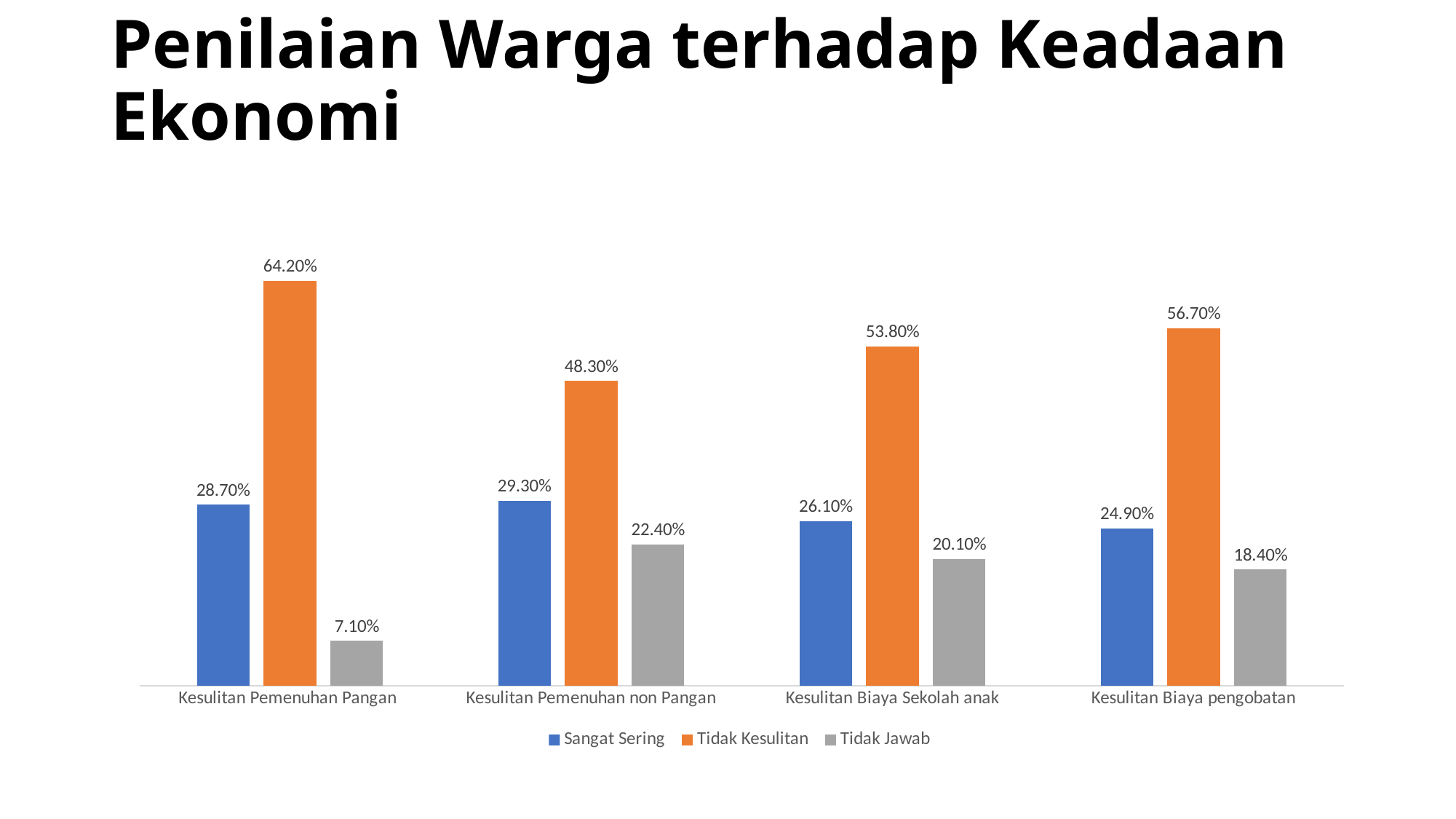
Which is larger: the Sangat Sering value for Kesulitan Pemenuhan non Pangan or for Kesulitan Biaya Sekolah anak? Kesulitan Pemenuhan non Pangan How many series does the legend list? 3 Which category has the lowest Tidak Jawab value? Kesulitan Pemenuhan Pangan What is the title of the slide? Penilaian Warga terhadap Keadaan Ekonomi What is the value of Sangat Sering for Kesulitan Biaya pengobatan? 24.90% Do the Tidak Kesulitan values rise or fall from Kesulitan Pemenuhan non Pangan to Kesulitan Biaya pengobatan? Rise What is the value of Tidak Jawab for Kesulitan Pemenuhan non Pangan? 22.40% Which category has the highest Tidak Kesulitan value? Kesulitan Pemenuhan Pangan What is the value of Tidak Kesulitan for Kesulitan Pemenuhan Pangan? 64.20% What is the difference between the Tidak Kesulitan values for Kesulitan Pemenuhan Pangan and Kesulitan Pemenuhan non Pangan? 15.90% What kind of chart is shown on the slide? Bar chart How many categories are shown on the x axis? 4